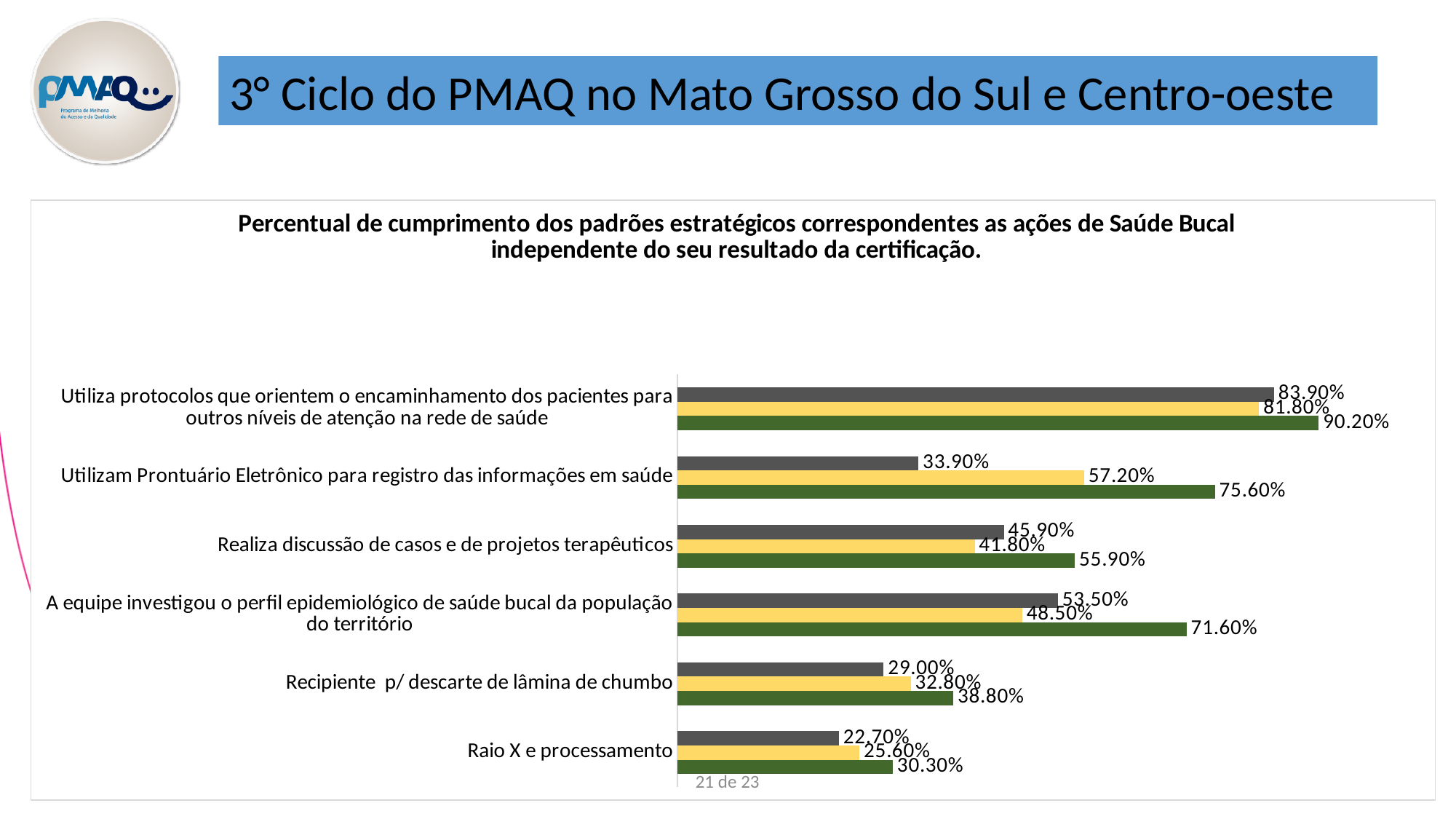
What is the value of the green bar for "Utilizam Prontuário Eletrônico para registro das informações em saúde"? 75.60% What is the title of the chart? Percentual de cumprimento dos padrões estratégicos correspondentes as ações de Saúde Bucal independente do seu resultado da certificação. What type of chart is shown on the slide? bar chart What is the difference between the green bar values for "Recipiente p/ descarte de lâmina de chumbo" and "Raio X e processamento"? 8.50% What is the value of the gray bar for "Raio X e processamento"? 22.70% Which category has the highest green bar value? Utiliza protocolos que orientem o encaminhamento dos pacientes para outros níveis de atenção na rede de saúde Which category has the lowest gray bar value? Raio X e processamento What is the value of the gray bar for "A equipe investigou o perfil epidemiológico de saúde bucal da população do território"? 53.50% What is the value of the yellow bar for "Recipiente p/ descarte de lâmina de chumbo"? 32.80% For "Realiza discussão de casos e de projetos terapêuticos", which is larger: the gray bar or the yellow bar? gray bar How many categories are shown on the chart? 6 What is the difference between the green and gray bar values for "Utilizam Prontuário Eletrônico para registro das informações em saúde"? 41.70%